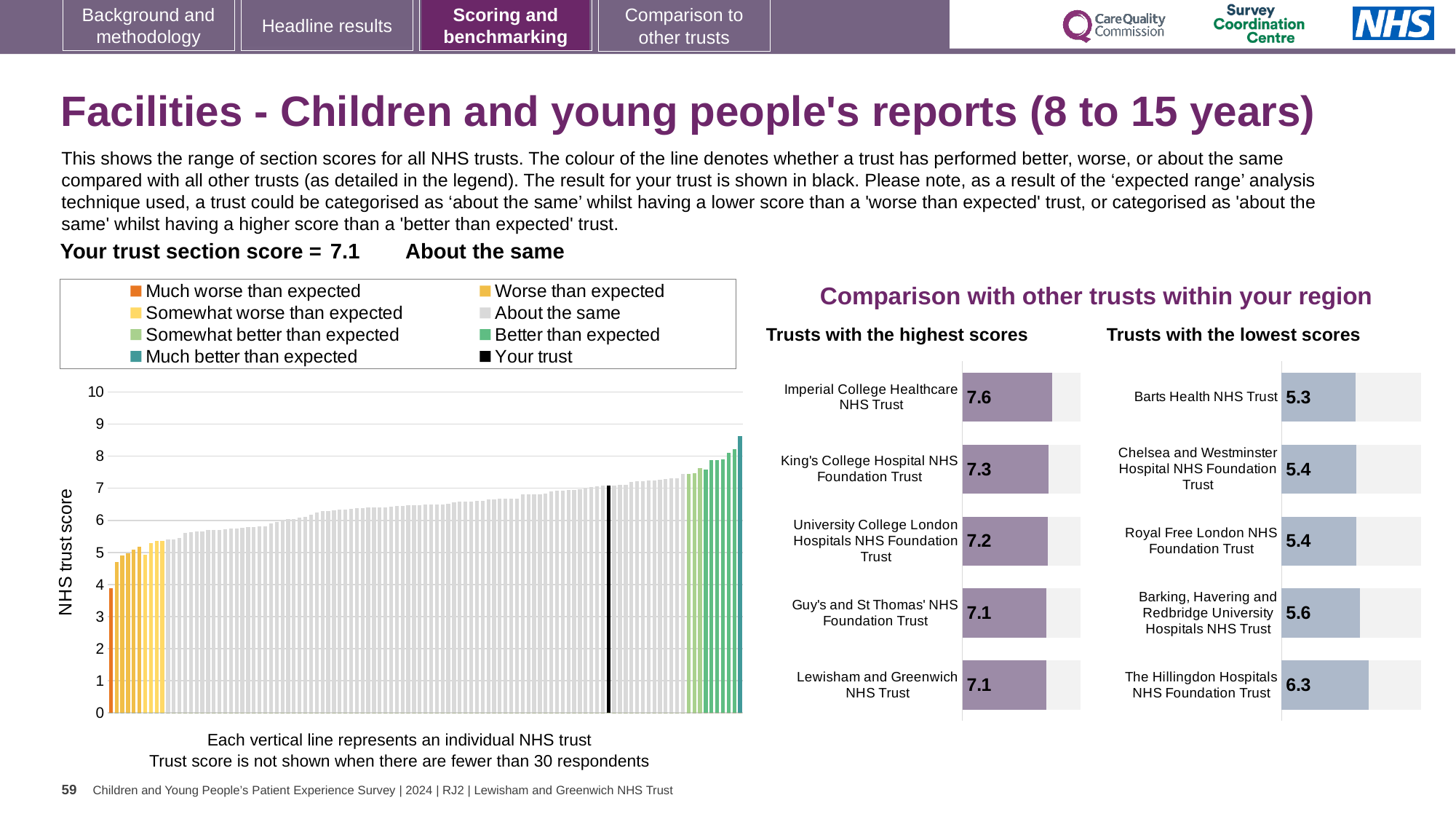
In the 'Trusts with the lowest scores' chart, what is the difference between the scores of The Hillingdon Hospitals NHS Foundation Trust and Barts Health NHS Trust? 1.0 In the 'Trusts with the highest scores' chart, which trust has the highest score? Imperial College Healthcare NHS Trust How many trusts are shown in the 'Trusts with the highest scores' chart? 5 In the 'Trusts with the lowest scores' chart, which has the larger score: Barking, Havering and Redbridge University Hospitals NHS Trust or Barts Health NHS Trust? Barking, Havering and Redbridge University Hospitals NHS Trust In the 'Trusts with the lowest scores' chart, what is the score for The Hillingdon Hospitals NHS Foundation Trust? 6.3 In the 'Trusts with the highest scores' chart, what is the score for Imperial College Healthcare NHS Trust? 7.6 In the main 'NHS trust score' chart, how many entries does the legend list? 8 In the 'Trusts with the lowest scores' chart, which trust has the lowest score? Barts Health NHS Trust In the main 'NHS trust score' chart, do the bar values rise or fall from left to right? Rise What kind of chart is the main 'NHS trust score' chart on the left? Bar chart In the 'Trusts with the highest scores' chart, what is the difference between the scores of Imperial College Healthcare NHS Trust and Lewisham and Greenwich NHS Trust? 0.5 In the 'Trusts with the highest scores' chart, what is the score for King's College Hospital NHS Foundation Trust? 7.3